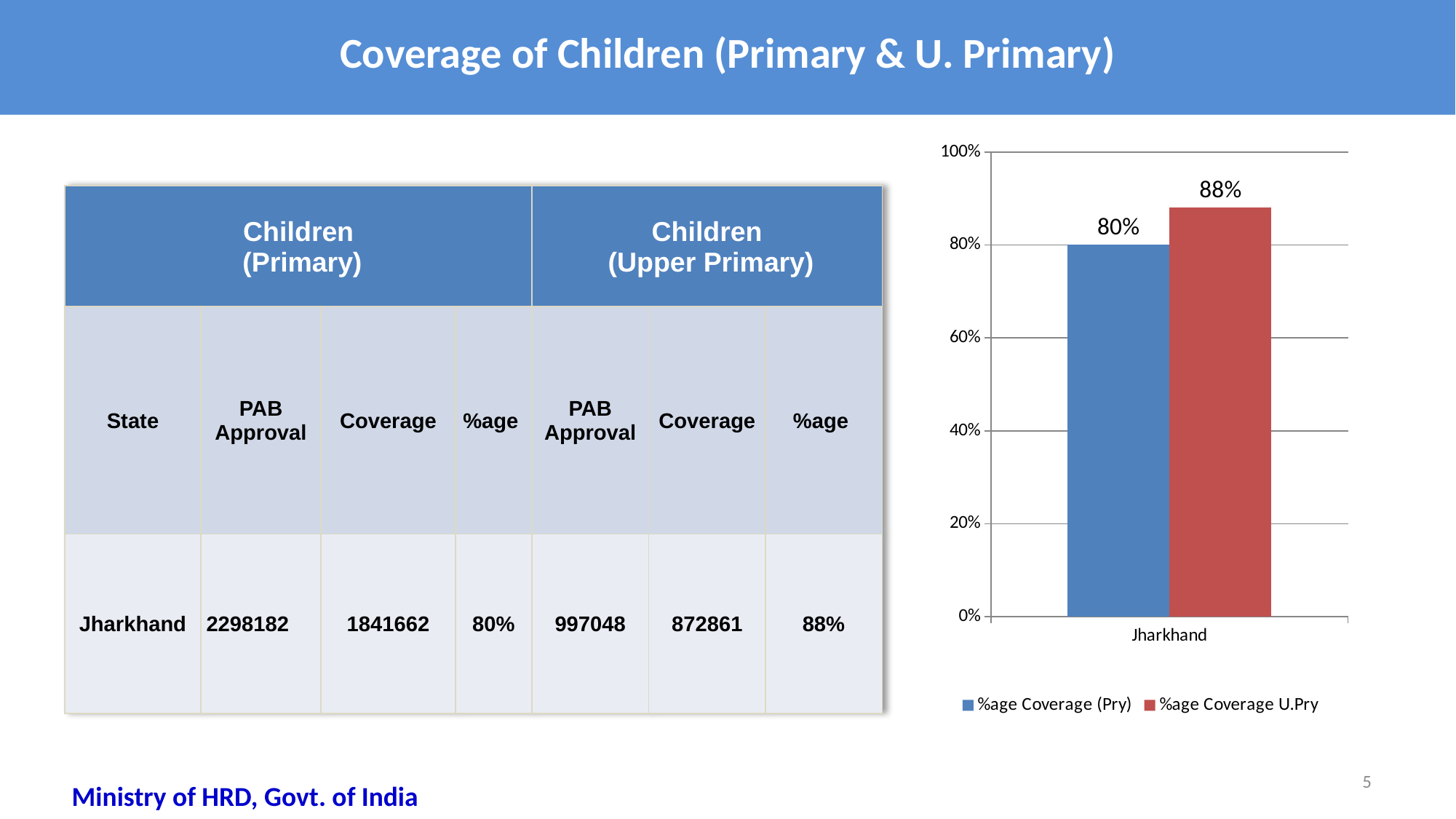
How many series does the chart legend list? 2 What colour is the bar for %age Coverage U.Pry in the chart? red What is the category label on the x axis of the chart? Jharkhand How many categories are shown on the x axis of the chart? 1 Which series has the higher value for Jharkhand in the chart? %age Coverage U.Pry What is the value of %age Coverage (Pry) for Jharkhand in the chart? 80% What is the difference between %age Coverage U.Pry and %age Coverage (Pry) for Jharkhand in the chart? 8% What kind of chart is shown on the slide? bar chart What is the value of %age Coverage U.Pry for Jharkhand in the chart? 88% Is %age Coverage (Pry) or %age Coverage U.Pry larger for Jharkhand in the chart? %age Coverage U.Pry Which series has the lower value for Jharkhand in the chart? %age Coverage (Pry) Is the value for %age Coverage U.Pry greater or less than 80%? greater